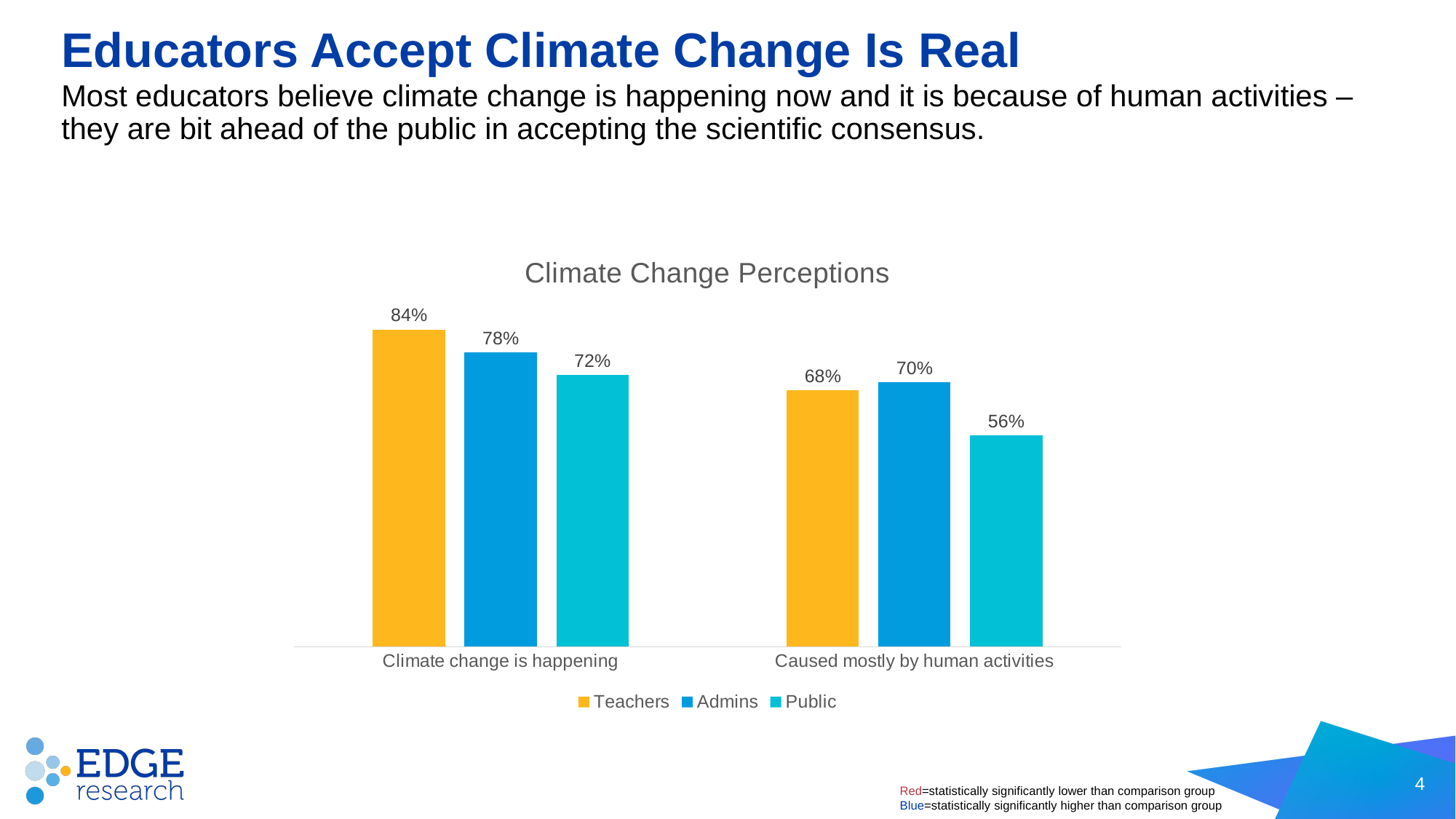
What kind of chart is shown on the slide? Bar chart Which is larger: the Teachers value or the Admins value for 'Caused mostly by human activities'? Admins What is the title of the chart? Climate Change Perceptions Which series has the highest value for 'Climate change is happening'? Teachers What is the value for Public in the 'Caused mostly by human activities' category? 56% What is the value for Admins in the 'Climate change is happening' category? 78% What percentage of Teachers say climate change is happening? 84% How many series does the legend list? 3 How many categories are shown on the x axis? 2 What is the difference between the Teachers and Public values for 'Climate change is happening'? 12% Which series has the lowest value for 'Caused mostly by human activities'? Public What is the difference between the Admins and Public values for 'Caused mostly by human activities'? 14%